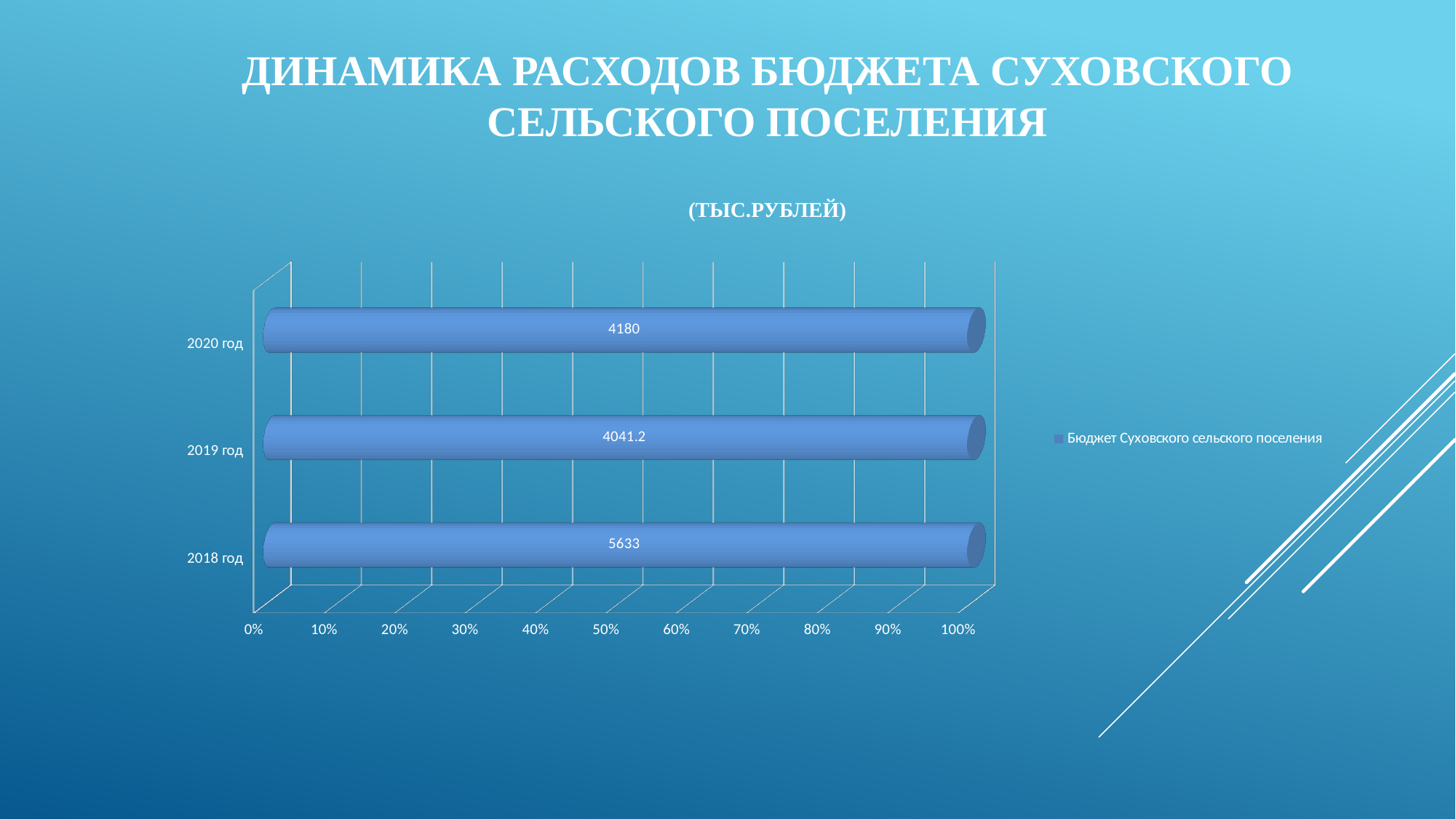
What is the difference between the labelled values for 2020 год and 2019 год? 138.8 How many series does the legend list? 1 Which labelled value is larger, 2019 год or 2020 год? 2020 год What is the data label on the bar for 2020 год? 4180 Which year has the highest labelled value? 2018 год Which year has the lowest labelled value? 2019 год What is the data label on the bar for 2018 год? 5633 What is the data label on the bar for 2019 год? 4041.2 What kind of chart is shown on the slide? Bar chart How many years (categories) are shown on the chart? 3 What is the difference between the labelled values for 2018 год and 2020 год? 1453 What is the legend entry of the chart? Бюджет Суховского сельского поселения